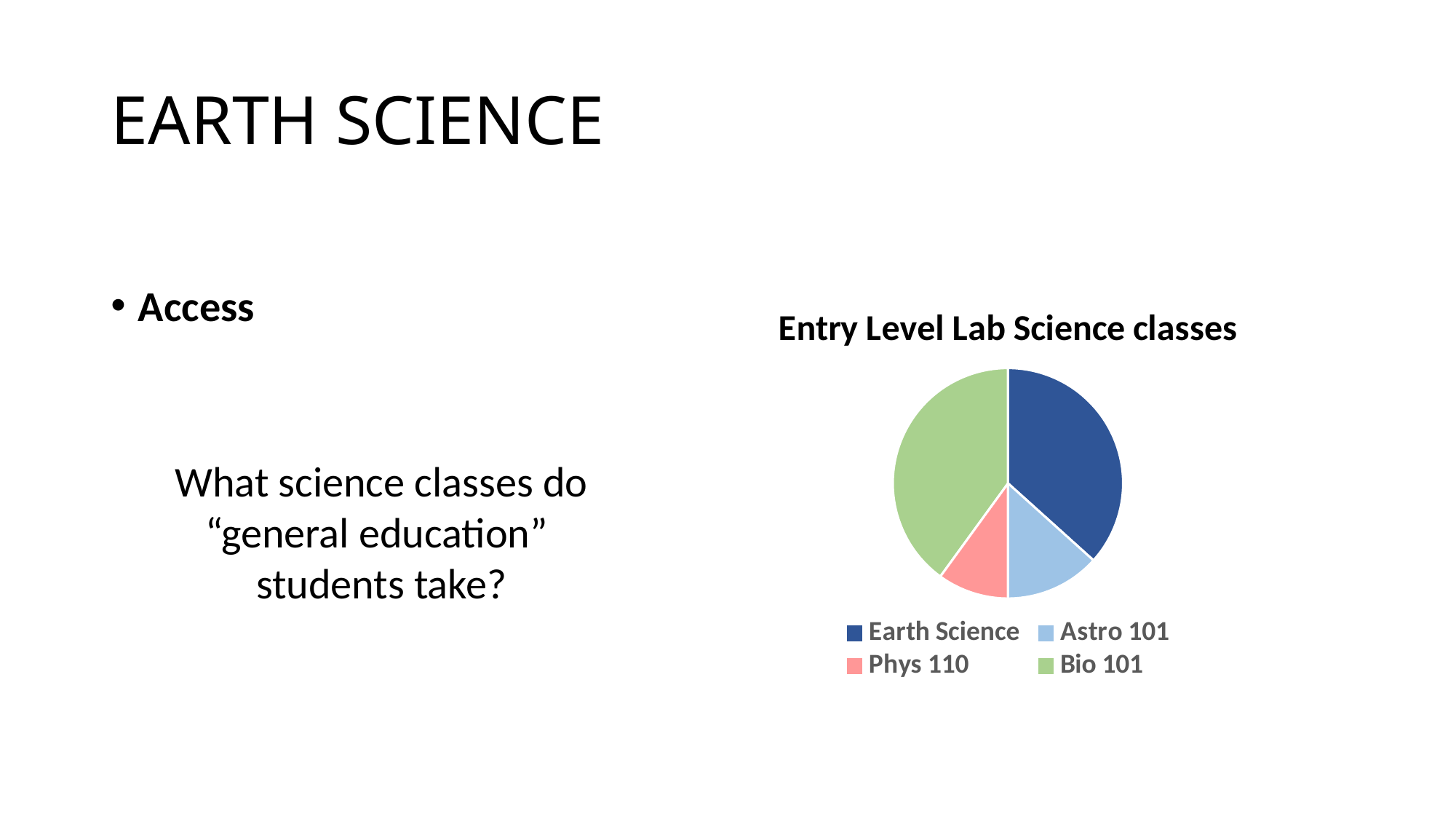
How many slices does the pie chart have? 4 Which slice is larger, Earth Science or Astro 101? Earth Science Which colour represents Bio 101 in the pie chart? green Which slice is larger, Bio 101 or Phys 110? Bio 101 Which slice is larger, Astro 101 or Phys 110? Astro 101 How many entries does the legend of the pie chart list? 4 Which class has the largest slice in the pie chart? Bio 101 Which class has the smallest slice in the pie chart? Phys 110 What is the title of the pie chart? Entry Level Lab Science classes What kind of chart is shown on the slide? pie chart